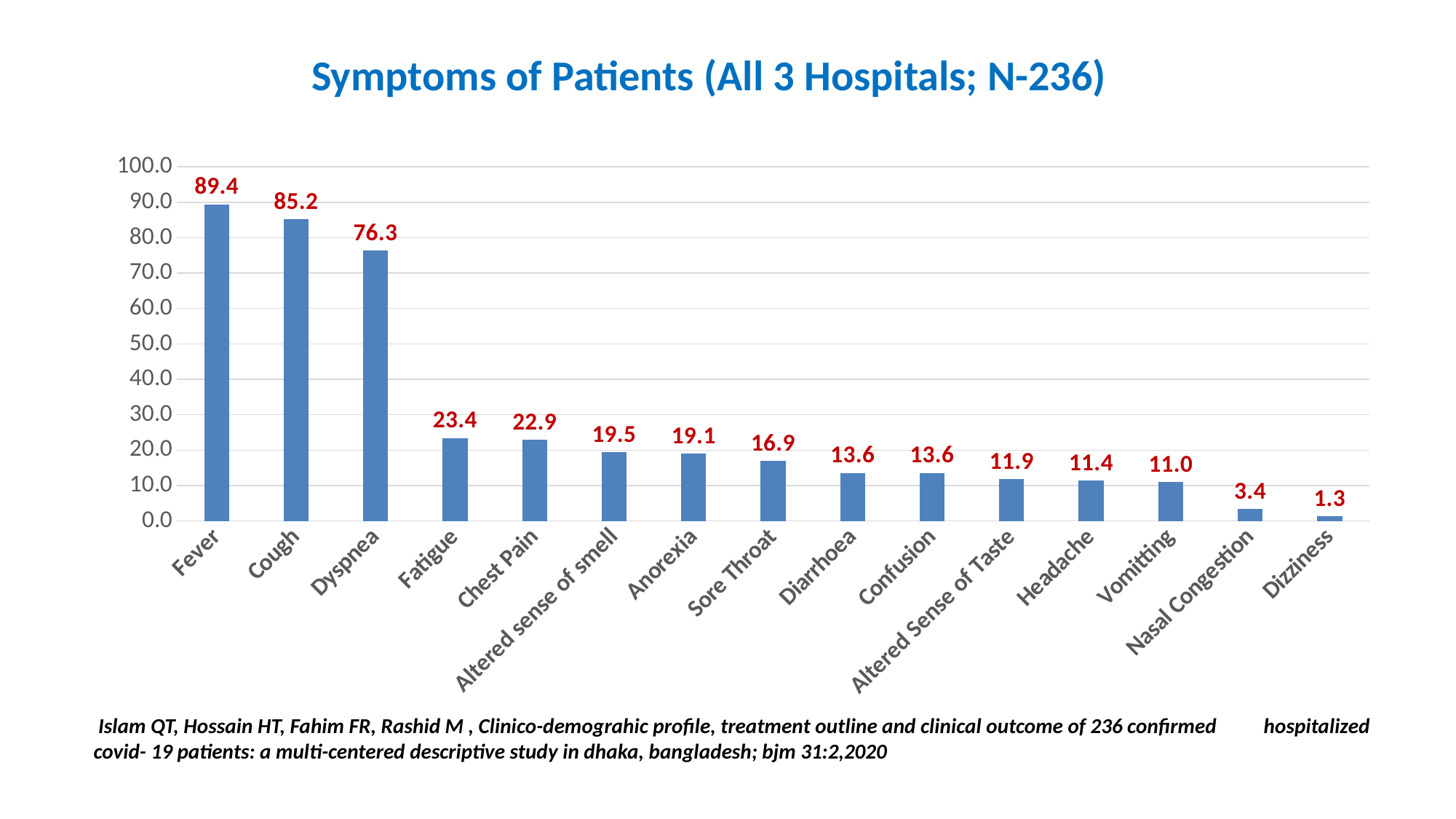
Which symptom has the highest value? Fever What is the value for Altered sense of smell? 19.5 Which symptom has the lowest value? Dizziness Which is larger, the value for Fatigue or the value for Sore Throat? Fatigue How many symptom categories are shown on the chart? 15 What is the difference between the values for Cough and Dyspnea? 8.9 Do the values rise or fall from left to right along the x axis? Fall What is the title of the chart? Symptoms of Patients (All 3 Hospitals; N-236) Is the value for Dyspnea greater or less than 70.0? greater What is the value for Nasal Congestion? 3.4 What is the value for Fever? 89.4 What kind of chart is shown on the slide? Bar chart